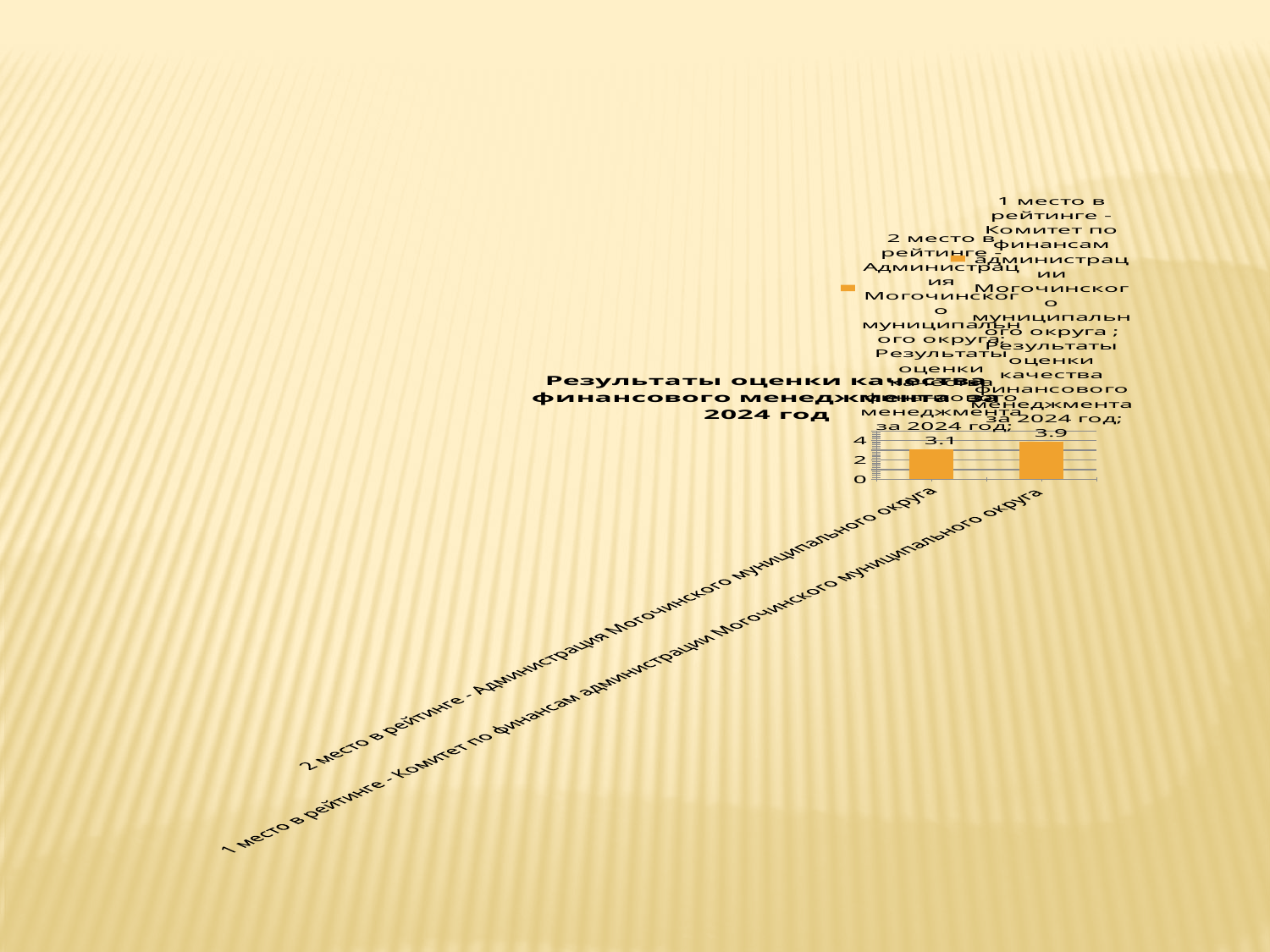
What is the difference between the value for the Комитет по финансам and the value for the Администрация Могочинского муниципального округа? 0.8 How many bars are plotted in the chart? 2 What is the value for the bar labelled '2 место в рейтинге - Администрация Могочинского муниципального округа'? 3.1 Which category has the lowest value? 2 место в рейтинге - Администрация Могочинского муниципального округа What is the highest tick value shown on the vertical axis? 4 Is the value for the Администрация Могочинского муниципального округа greater or less than 4? less What kind of chart is shown on the slide? bar chart What is the title of the chart? Результаты оценки качества финансового менеджмента за 2024 год Which is larger: the value for the Администрация Могочинского муниципального округа or the value for the Комитет по финансам администрации? Комитет по финансам администрации Могочинского муниципального округа Which category has the highest value? 1 место в рейтинге - Комитет по финансам администрации Могочинского муниципального округа What is the value for the bar labelled '1 место в рейтинге - Комитет по финансам администрации Могочинского муниципального округа'? 3.9 Is the value for the Комитет по финансам администрации Могочинского муниципального округа greater or less than 2? greater